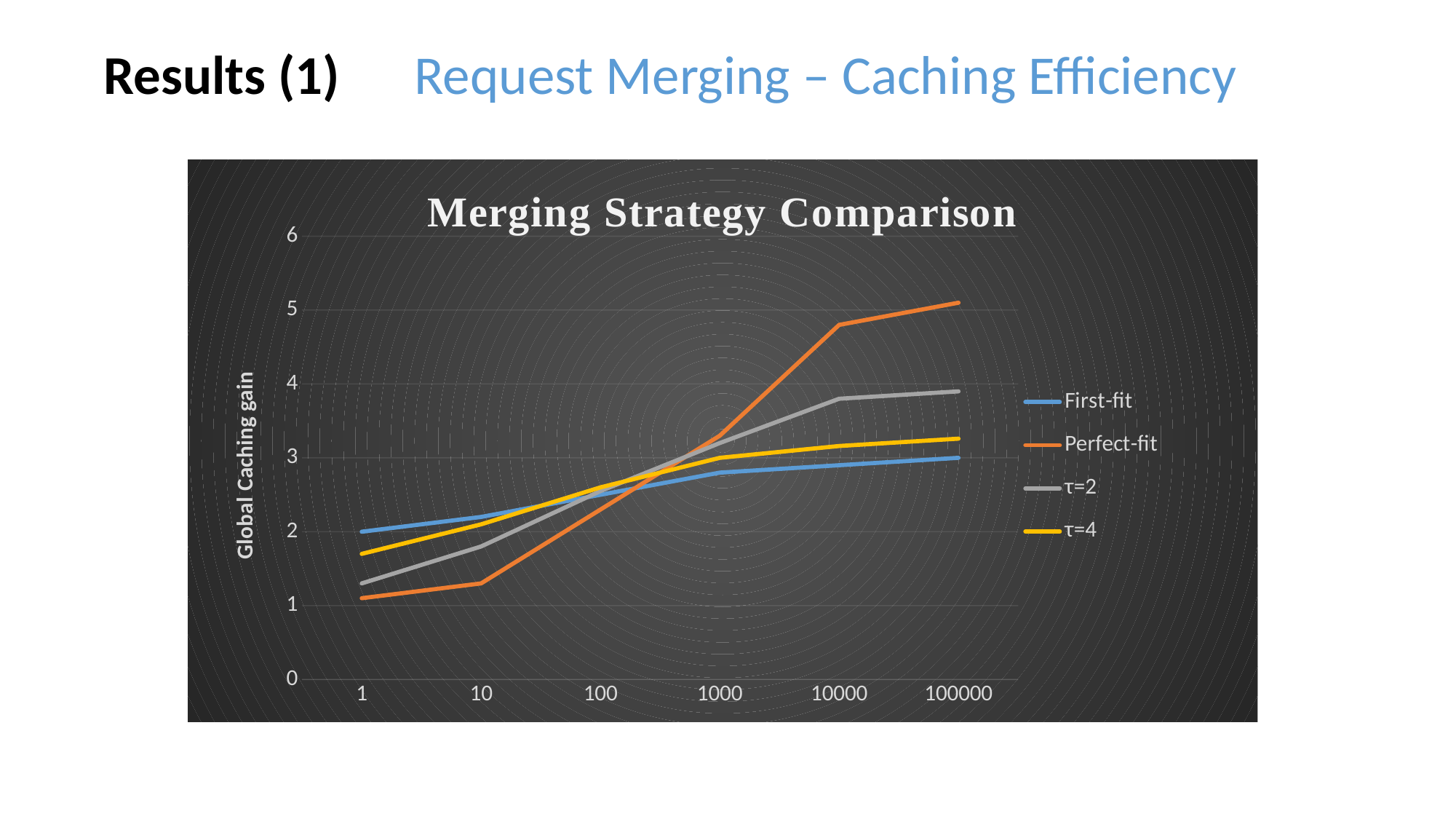
What kind of chart is shown on the slide? line chart How many points are plotted along the x axis for each series? 6 What is the title of the chart? Merging Strategy Comparison At x = 10000, which is larger: Perfect-fit or τ=2? Perfect-fit Which series has the lowest value at x = 1? Perfect-fit Which series has the highest value at x = 100000? Perfect-fit What is the label of the vertical axis? Global Caching gain At x = 1, which is larger: First-fit or τ=4? First-fit How many series does the legend list? 4 Do the values for Perfect-fit rise or fall as x increases? rise